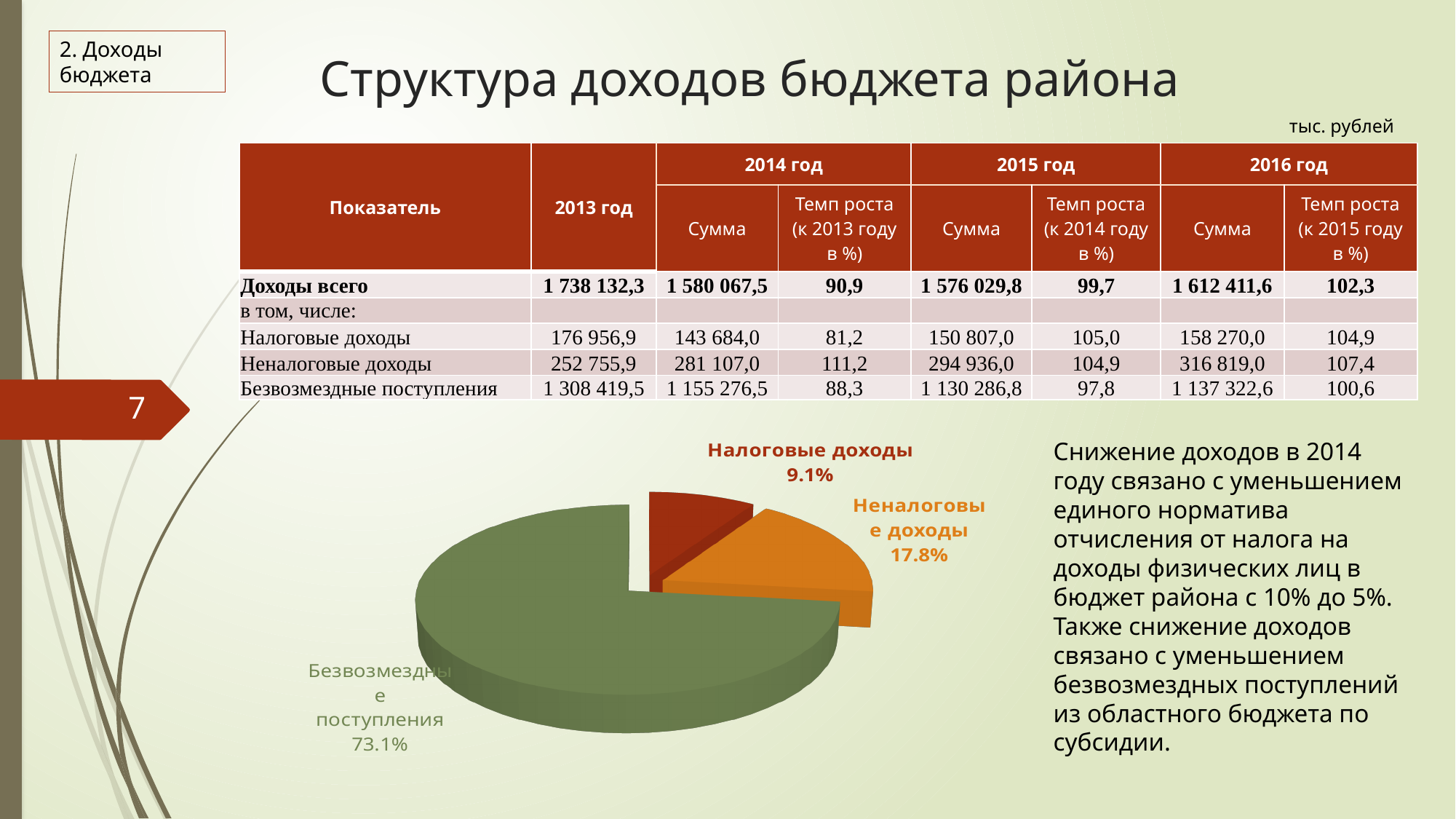
What share of the pie chart is labelled Неналоговые доходы? 17.8% What is the difference in percentage points between the Неналоговые доходы slice and the Налоговые доходы slice? 8.7 What share of the pie chart is labelled Налоговые доходы? 9.1% Which is larger in the pie chart: Налоговые доходы or Неналоговые доходы? Неналоговые доходы What colour is the Неналоговые доходы slice in the pie chart? Orange What share of the pie chart is labelled Безвозмездные поступления? 73.1% What kind of chart is shown on the slide? Pie chart What colour is the Безвозмездные поступления slice in the pie chart? Green Which slice of the pie chart is the largest? Безвозмездные поступления How many slices does the pie chart have? 3 What is the difference in percentage points between the Безвозмездные поступления slice and the Неналоговые доходы slice? 55.3 Which slice of the pie chart is the smallest? Налоговые доходы